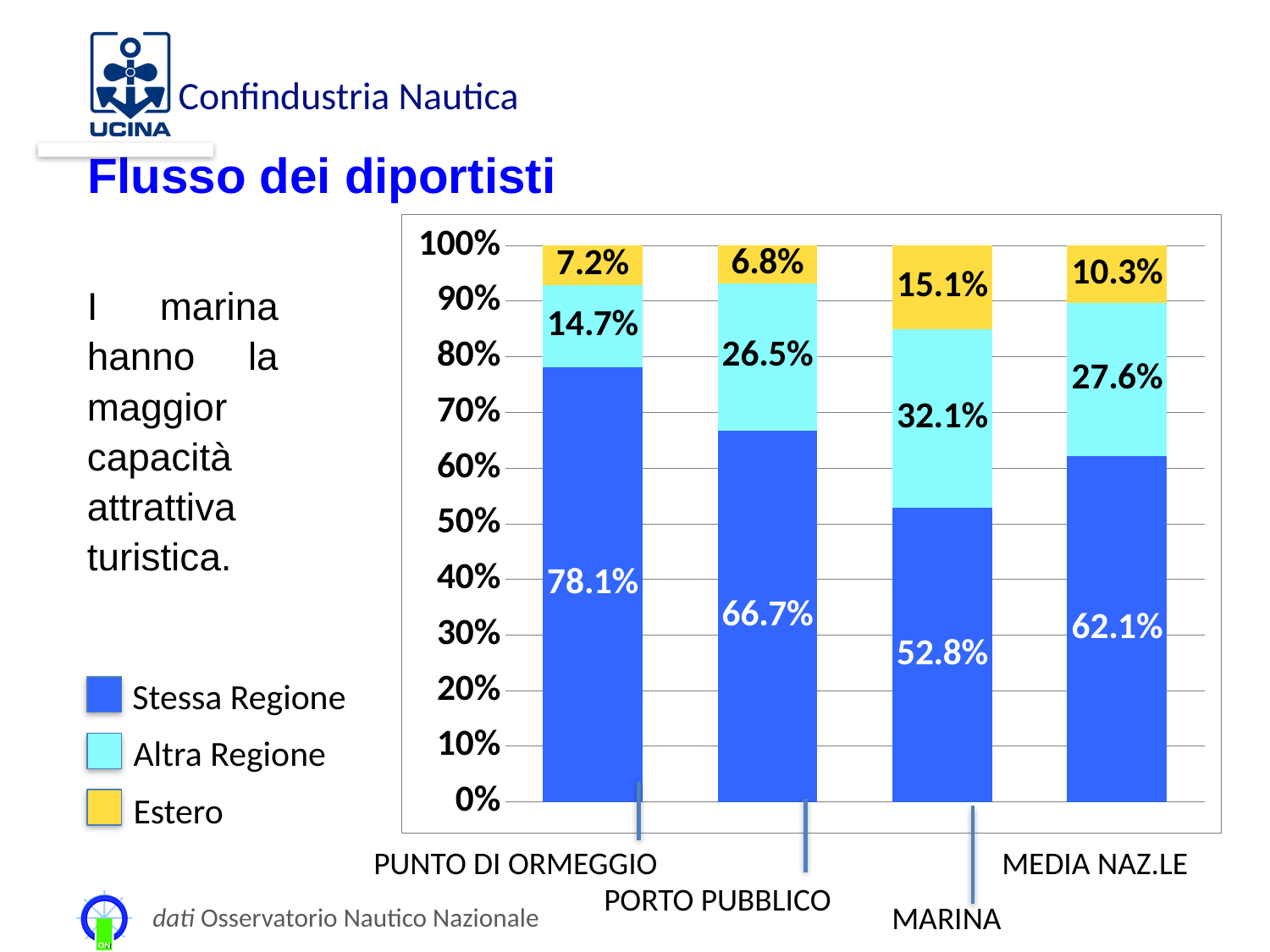
What kind of chart is shown on the slide? Stacked bar chart How many categories are shown on the x axis? 4 What is the difference between the Stessa Regione values for PUNTO DI ORMEGGIO and MARINA? 25.3% What is the Estero value for PORTO PUBBLICO? 6.8% What is the Altra Regione value for MEDIA NAZ.LE? 27.6% Which category has the highest Stessa Regione value? PUNTO DI ORMEGGIO Which category has the lowest Estero value? PORTO PUBBLICO What is the Stessa Regione value for MARINA? 52.8% Which category has the highest Altra Regione value? MARINA How many series does the legend list? 3 What is the title of the slide containing the chart? Flusso dei diportisti Which is larger, the Estero value for MARINA or for MEDIA NAZ.LE? MARINA